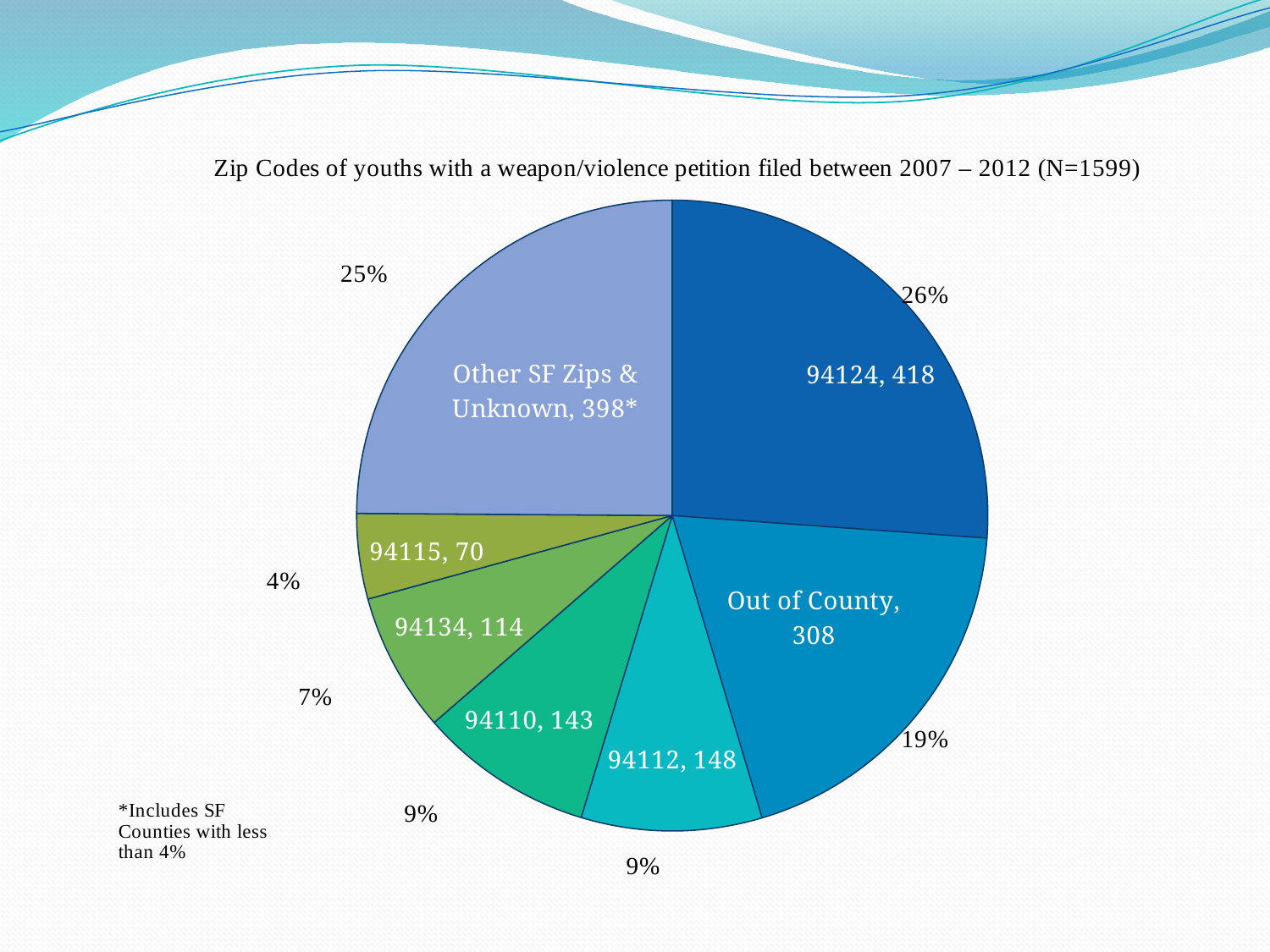
What type of chart is shown on the slide? pie chart How many slices does the pie chart have? 7 What is the value for Out of County? 308 Which is larger, the value for 94134 or the value for 94115? 94134 What is the title of the chart? Zip Codes of youths with a weapon/violence petition filed between 2007 – 2012 (N=1599) What is the difference between the values for 94112 and 94110? 5 What share of the pie does Out of County represent? 19% Which category has the smallest slice of the pie? 94115 What is the value for zip code 94124? 418 Which category has the largest slice of the pie? 94124 What share of the pie does Other SF Zips & Unknown represent? 25% What is the value for zip code 94115? 70